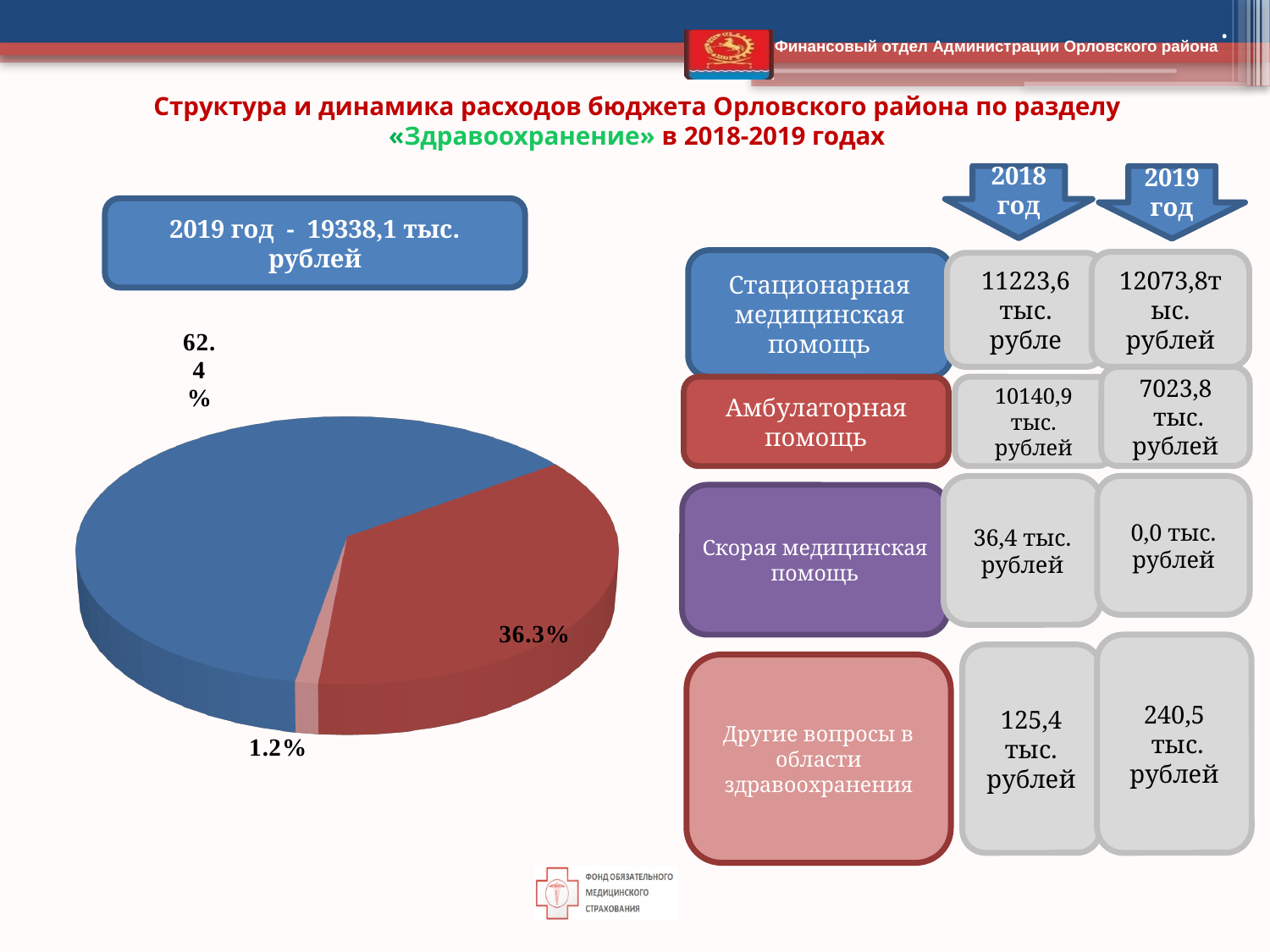
Is the largest slice of the pie chart greater or less than 50%? greater What share is labelled on the red slice of the pie chart? 36.3% What total amount for 2019 is stated in the box above the pie chart? 19338,1 тыс. рублей What is the difference in percentage points between the 36.3% slice and the 1.2% slice? 35.1 What is the difference in percentage points between the largest slice (62.4%) and the second largest slice (36.3%)? 26.1 Is the slice labelled 36.3% greater or less than 50% of the pie? less What share is labelled on the blue slice of the pie chart? 62.4% What is the largest share shown on the pie chart? 62.4% Which slice is larger: the one labelled 36.3% or the one labelled 1.2%? 36.3% What type of chart is shown on the slide? pie chart How many slices does the pie chart have? 3 What is the smallest share shown on the pie chart? 1.2%